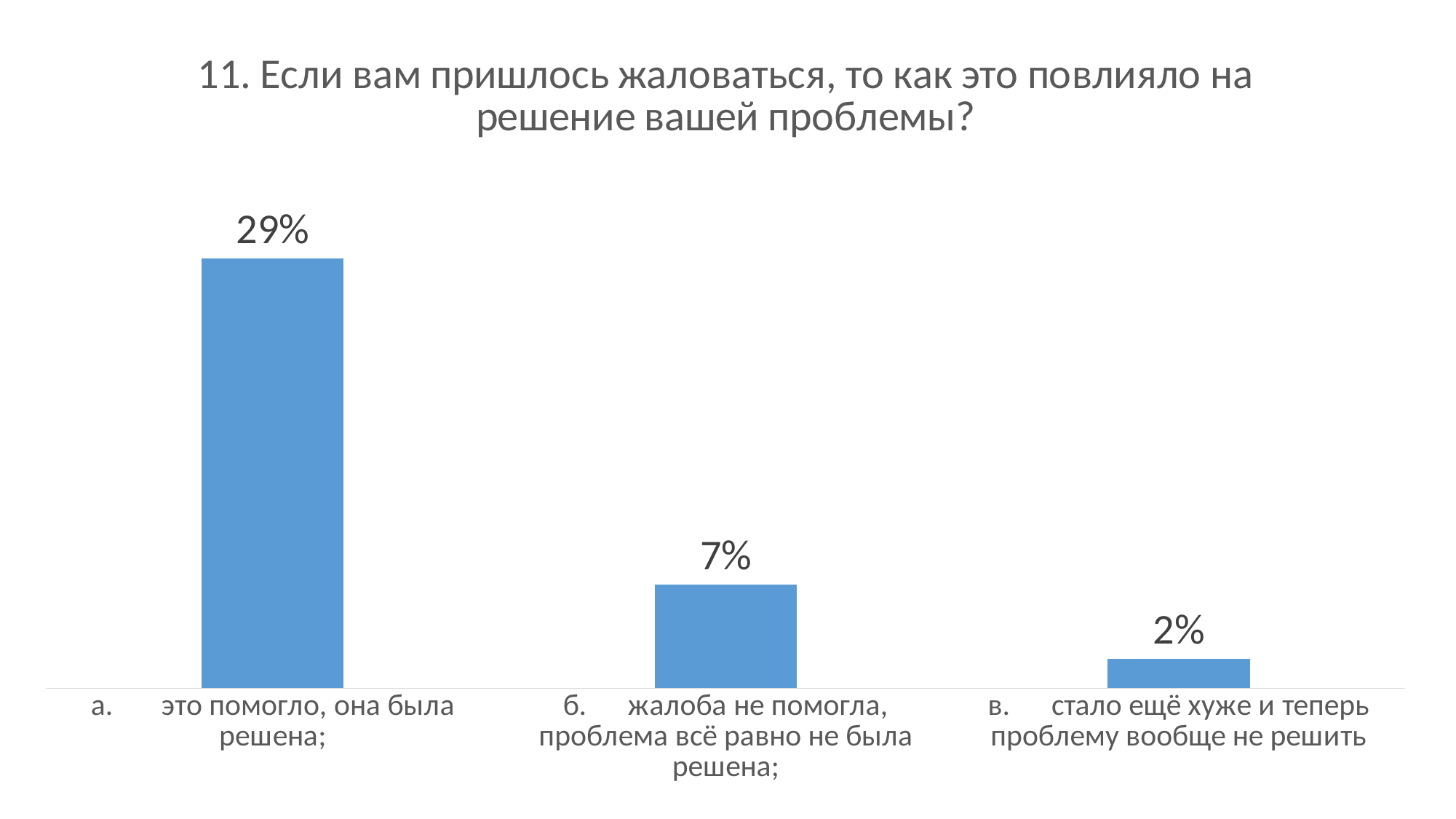
How many categories are shown in the chart? 3 Do the values rise or fall from left to right across the categories? fall Which category has the highest value? а. это помогло, она была решена Which category has the lowest value? в. стало ещё хуже и теперь проблему вообще не решить What kind of chart is shown on the slide? bar chart What is the value for option а (это помогло, она была решена)? 29% What is the value for option б (жалоба не помогла, проблема всё равно не была решена)? 7% Which is larger: the value for option б or the value for option в? option б (7%) What is the title of the chart? 11. Если вам пришлось жаловаться, то как это повлияло на решение вашей проблемы? What is the value for option в (стало ещё хуже и теперь проблему вообще не решить)? 2% What is the difference between the values for option б and option в? 5% What is the difference between the values for option а and option б? 22%